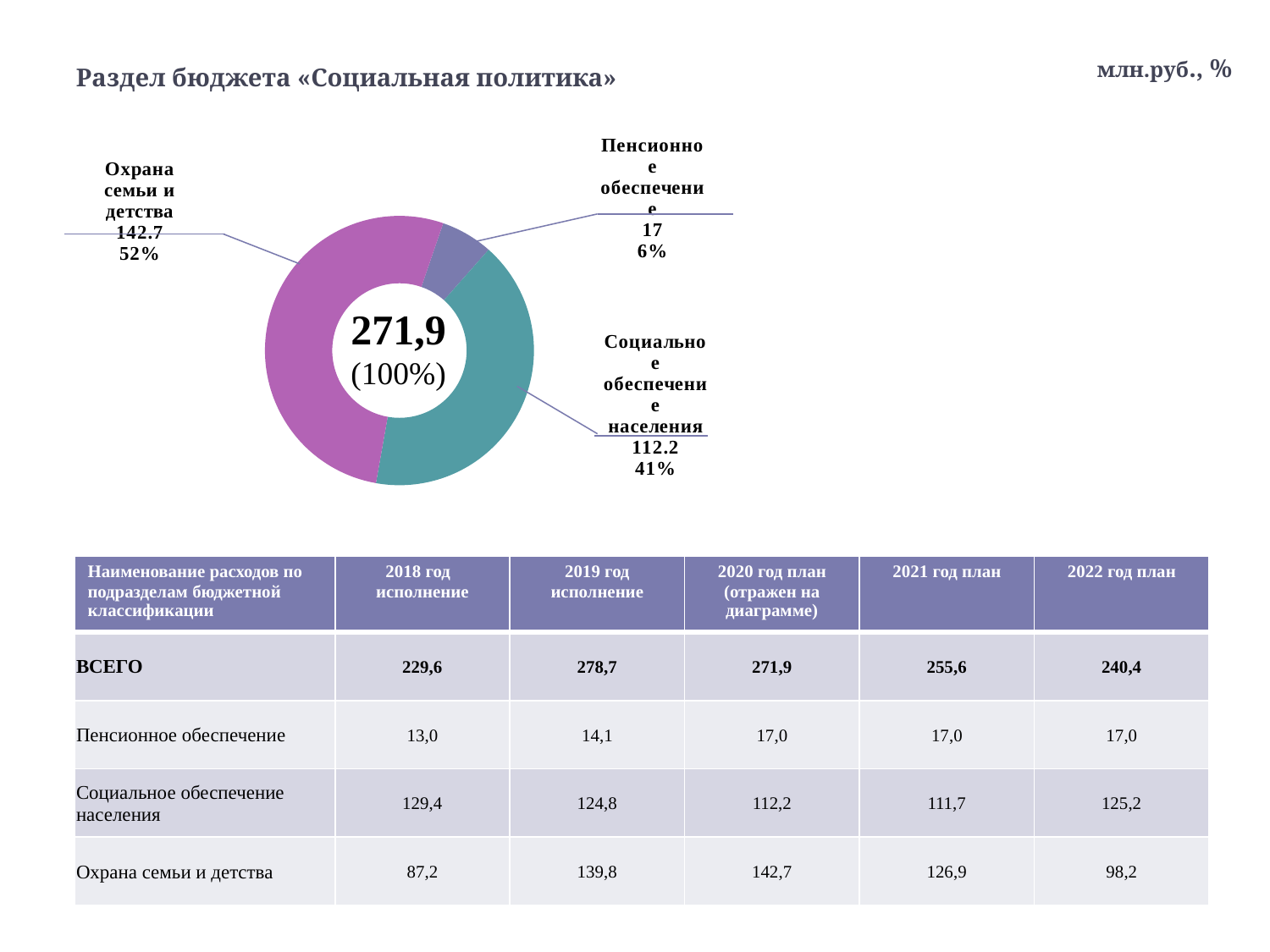
What share of the chart does «Социальное обеспечение населения» represent? 41% What total value is shown in the centre of the doughnut chart? 271,9 What share of the chart does «Охрана семьи и детства» represent? 52% Which slice of the chart is the smallest? Пенсионное обеспечение What value is shown for «Социальное обеспечение населения» on the chart? 112.2 What value is shown for «Охрана семьи и детства» on the chart? 142.7 What is the difference between the values for «Охрана семьи и детства» and «Социальное обеспечение населения» on the chart? 30.5 What kind of chart is shown on the slide? Doughnut (pie) chart Which slice of the chart is the largest? Охрана семьи и детства How many slices does the doughnut chart have? 3 What value is shown for «Пенсионное обеспечение» on the chart? 17 What share of the chart does «Пенсионное обеспечение» represent? 6%